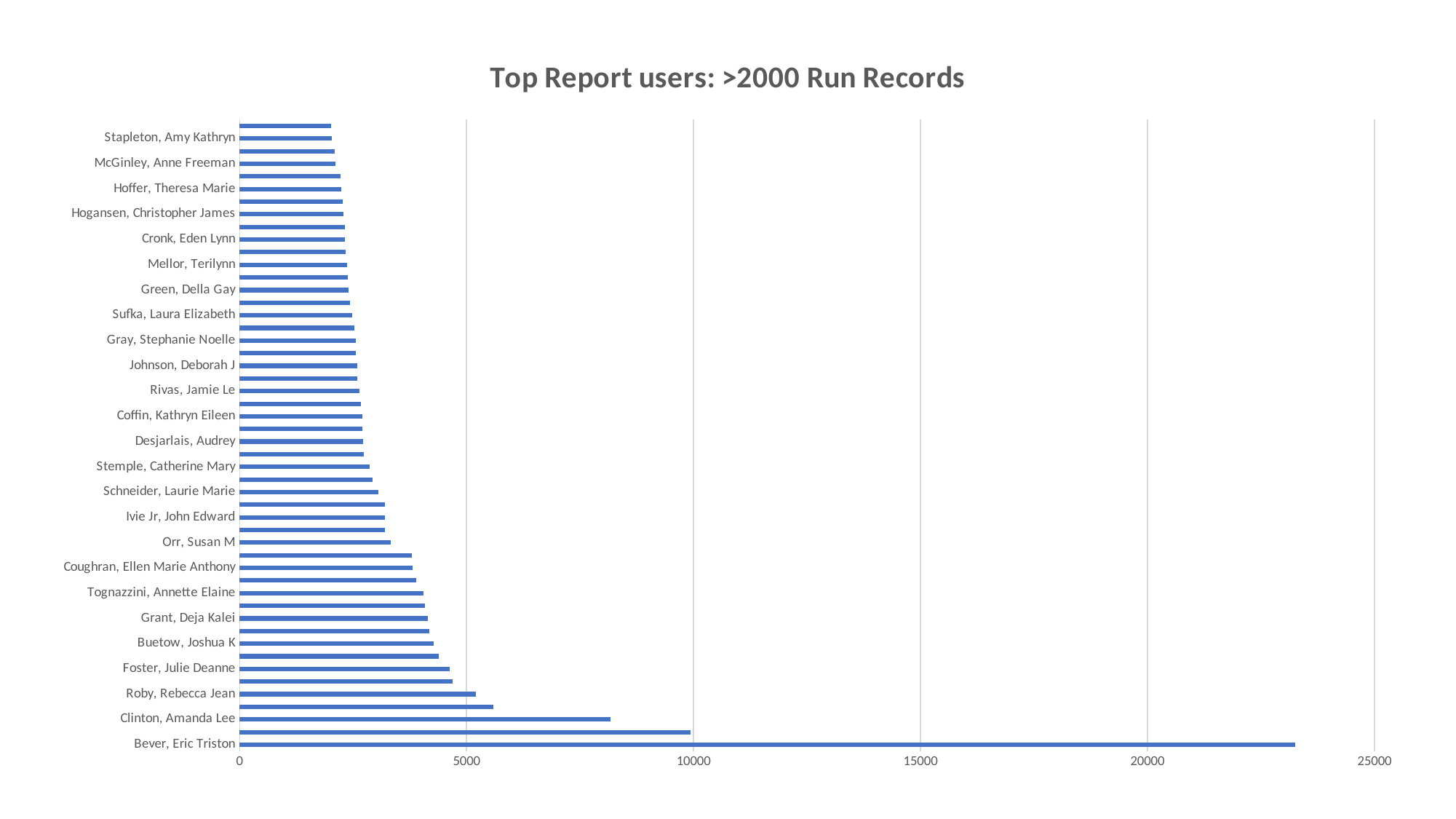
Is the value for Stapleton, Amy Kathryn greater or less than 5000? less What is the title of the chart? Top Report users: >2000 Run Records Is the value for Bever, Eric Triston greater or less than 20000? greater Which is larger, the value for Clinton, Amanda Lee or the value for Stapleton, Amy Kathryn? Clinton, Amanda Lee What kind of chart is shown on the slide? bar chart Is the value for Clinton, Amanda Lee greater or less than 10000? less Which is larger, the value for Bever, Eric Triston or the value for Clinton, Amanda Lee? Bever, Eric Triston Which user has the highest number of run records? Bever, Eric Triston Do the bar lengths increase or decrease going from the top of the chart to the bottom? increase What is the maximum value shown on the horizontal axis? 25000